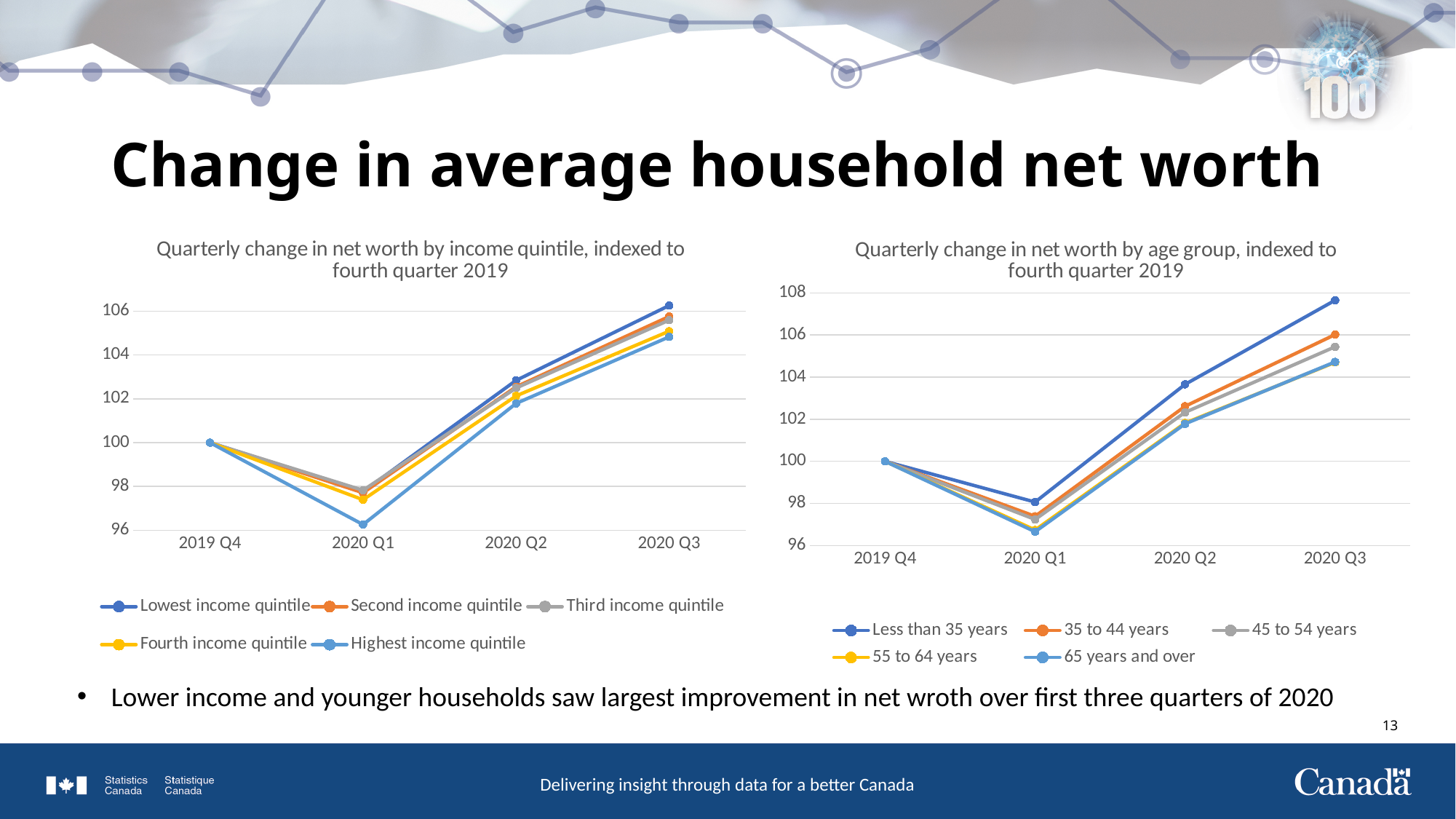
In the left chart (by income quintile), how many quarters are plotted on the x axis? 4 What type of chart is the left chart, 'Quarterly change in net worth by income quintile'? line chart In the left chart (by income quintile), do the values rise or fall between 2020 Q1 and 2020 Q3? rise In the right chart (by age group), how many series does the legend list? 5 In the left chart (by income quintile), is the value for the Highest income quintile in 2020 Q1 greater or less than 98? less In the right chart (by age group), which is larger in 2020 Q2: the value for Less than 35 years or the value for 65 years and over? Less than 35 years In the left chart (by income quintile), what is the value for the Lowest income quintile in 2019 Q4? 100 In the right chart (by age group), which series has the highest value in 2020 Q3? Less than 35 years In the left chart (by income quintile), how many series does the legend list? 5 In the left chart (by income quintile), which series has the highest value in 2020 Q3? Lowest income quintile In the left chart (by income quintile), which series has the lowest value in 2020 Q1? Highest income quintile In the right chart (by age group), is the value for Less than 35 years in 2020 Q3 greater or less than 106? greater